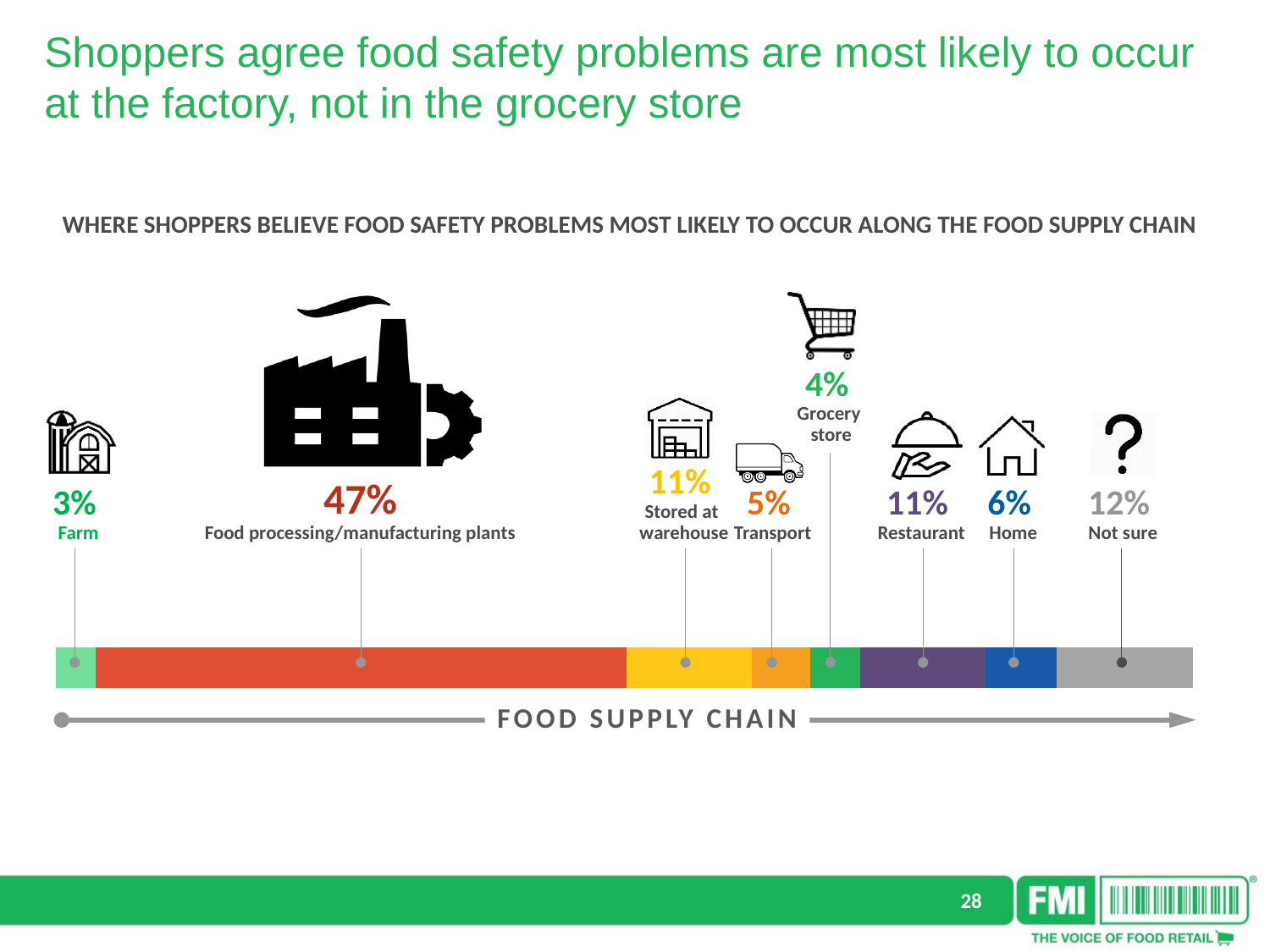
What kind of chart is shown on the slide? Stacked bar chart Which has a higher percentage, Transport or Home? Home What percentage of shoppers believe food safety problems are most likely to occur in the grocery store? 4% What label appears beneath the bar along the arrow? FOOD SUPPLY CHAIN How many categories are shown along the bar? 8 What percentage of shoppers answered 'Not sure'? 12% What percentage of shoppers believe food safety problems are most likely to occur at the farm? 3% What is the combined percentage for Stored at warehouse and Restaurant? 22% What is the difference between the percentage for food processing/manufacturing plants and the percentage for stored at warehouse? 36% What percentage of shoppers believe food safety problems are most likely to occur at food processing/manufacturing plants? 47% Which stage of the food supply chain has the highest percentage? Food processing/manufacturing plants Which category has the lowest percentage? Farm